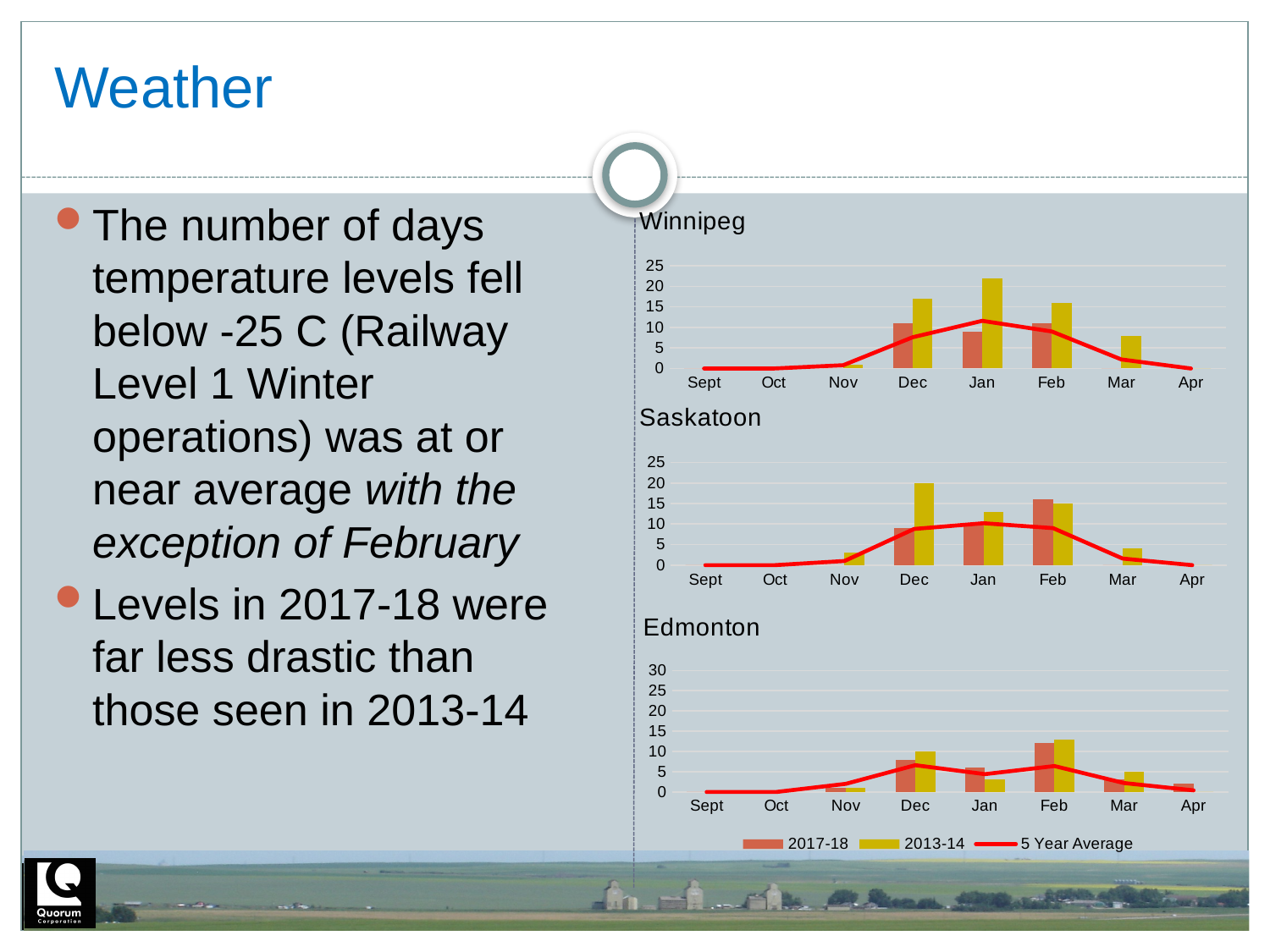
In the Saskatoon chart, which month has the highest 2013-14 value? Dec In the Winnipeg chart, how many months are shown on the x axis? 8 In the Winnipeg chart, is the 2013-14 value for Jan greater or less than 20? greater In the Winnipeg chart, do the 2013-14 values rise or fall from Jan to Apr? fall In the Edmonton chart, is the 2013-14 value for Feb greater or less than 10? greater In the Edmonton chart, which month has the highest 2017-18 value? Feb How many series does the legend list for the charts? 3 In the Winnipeg chart, which is larger for Jan: the 2013-14 value or the 2017-18 value? 2013-14 In the Winnipeg chart, which month has the highest 2013-14 value? Jan In the Winnipeg chart, is the 2013-14 value for Mar greater or less than 10? less What kind of chart is the Saskatoon chart? Bar chart with a line How many charts are shown on the slide? 3